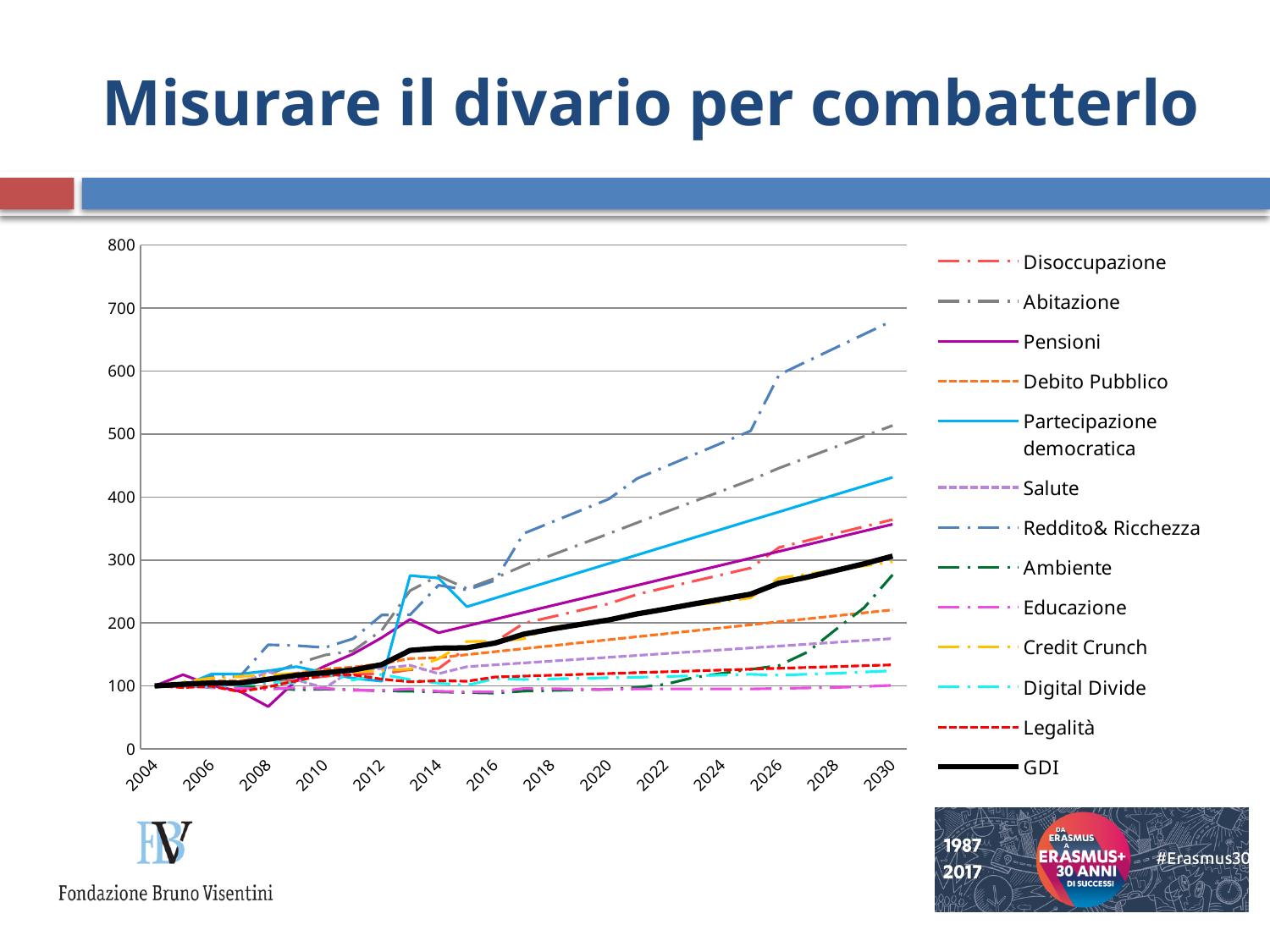
What kind of chart is shown on the slide? line chart Is the value for Partecipazione democratica in 2030 greater or less than 400? greater How many year labels are shown on the x axis? 14 Which series has the lowest value in 2030? Educazione Does the GDI line rise or fall from 2004 to 2030? rise Is the value for GDI in 2030 greater or less than 200? greater Which legend entry is drawn as the thick black line? GDI How many series does the legend list? 13 Is the value for Legalità in 2030 greater or less than 200? less In 2030, which is larger: Pensioni or Salute? Pensioni Which series has the highest value in 2030? Reddito& Ricchezza